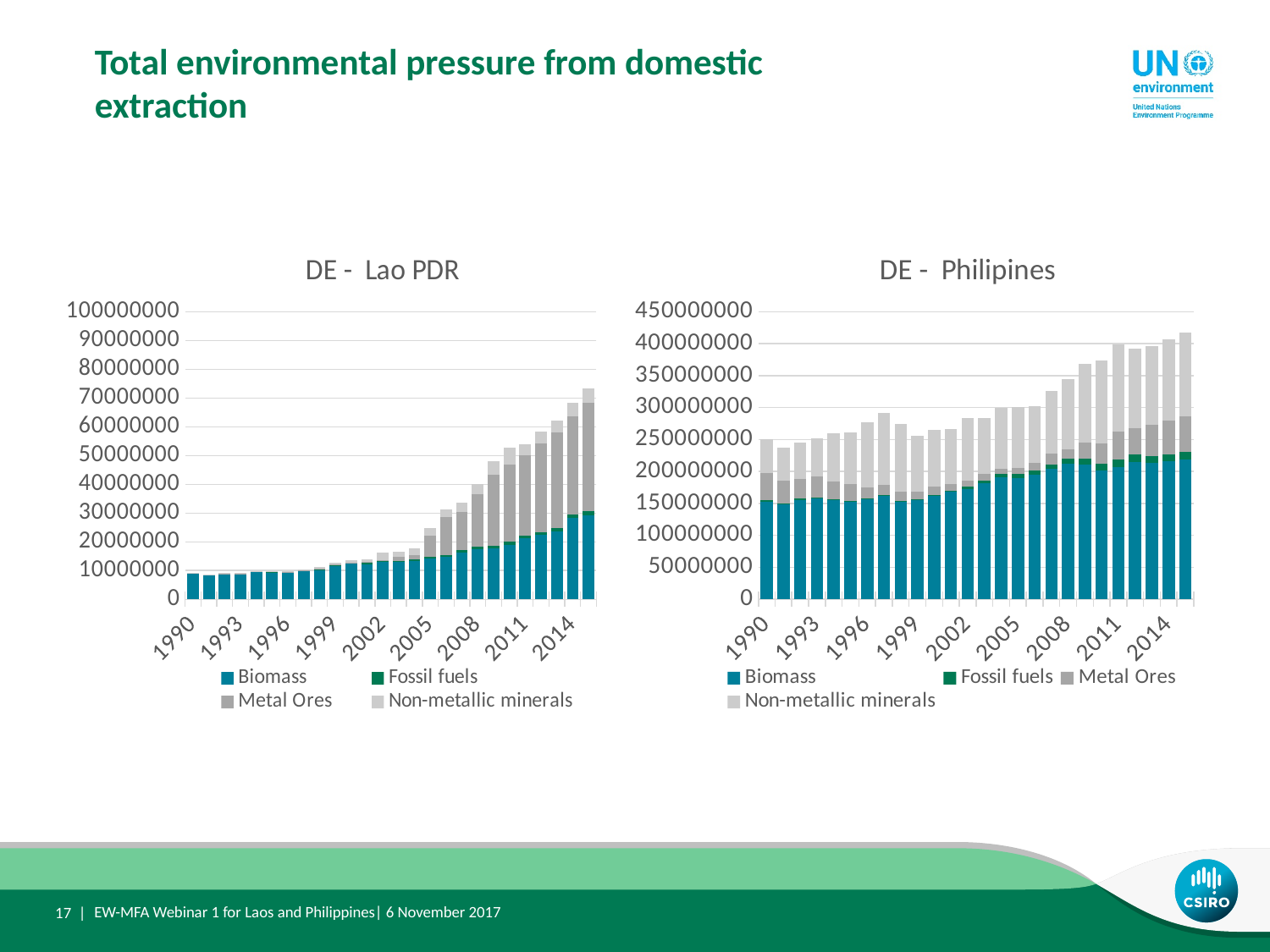
What type of chart is the 'DE - Lao PDR' chart? Stacked bar chart In the 'DE - Lao PDR' chart, do the total bar heights generally rise or fall from 1990 to the last year shown? Rise In the 'DE - Lao PDR' chart, which year has the larger total bar, 2011 or 2014? 2014 How many series does the legend of the 'DE - Philipines' chart list? 4 In the 'DE - Philipines' chart, is the total bar height for 2008 greater or less than 300000000? greater Which series is shown at the bottom of each stacked bar in the 'DE - Lao PDR' chart? Biomass In the 'DE - Philipines' chart, do the total bar heights generally rise or fall from 1990 to the last year shown? Rise In the 'DE - Philipines' chart, is the total bar height for 1996 greater or less than 250000000? greater In the 'DE - Lao PDR' chart, is the total bar height for 2014 greater or less than 60000000? greater In the 'DE - Philipines' chart, which year has the larger total bar, 1990 or 2014? 2014